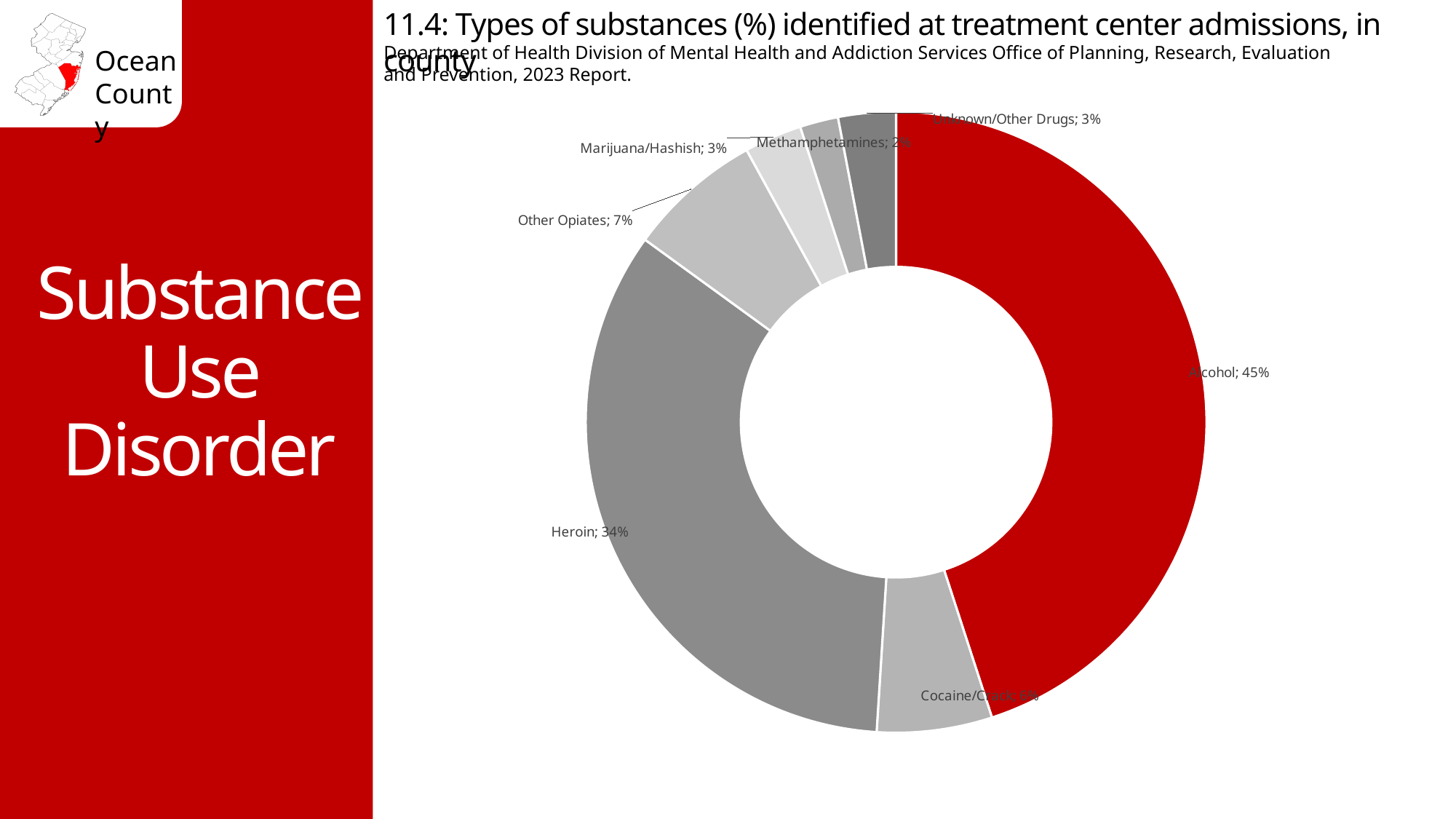
Which substance has the largest share of admissions? Alcohol What colour is the Alcohol slice? Red What kind of chart is used on this slide? Doughnut (pie) chart What percentage is shown for Marijuana/Hashish? 3% What percentage is shown for Other Opiates? 7% Which is larger, the share for Heroin or the share for Other Opiates? Heroin What percentage is shown for Methamphetamines? 2% How many substance categories are shown in the chart? 7 What percentage of treatment center admissions identified Alcohol? 45% What percentage is shown for Heroin? 34% Which substance has the smallest share of admissions? Methamphetamines How many percentage points higher is Alcohol than Heroin? 11